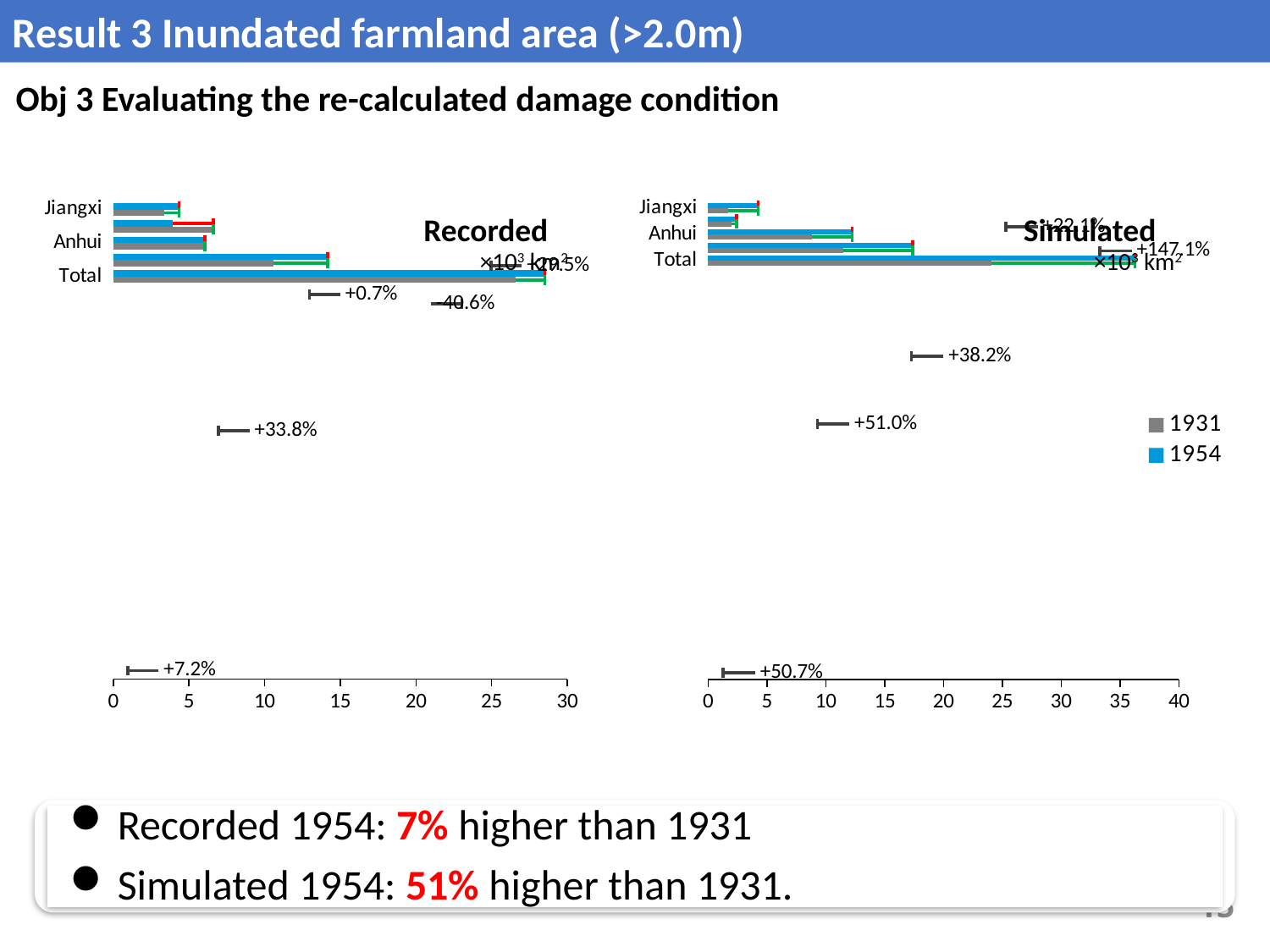
In the Recorded chart, which category has the longest bars? Total In the Simulated chart, is the value for Jiangxi in 1954 greater or less than 10? less How many series does the legend list for the charts? 2 What is the maximum value shown on the x axis of the Simulated chart? 40 In the Simulated chart, is the value for Total in 1954 greater or less than 30? greater How many categories are shown on the y axis of the Simulated chart? 3 What kind of chart is the Recorded chart on the left? bar chart In the Recorded chart, is the value for Total in 1954 greater or less than 20? greater Which two years are listed in the legend? 1931 and 1954 In the Simulated chart, which is larger for Total: 1931 or 1954? 1954 Which chart shows the larger Total value for 1954, Recorded or Simulated? Simulated